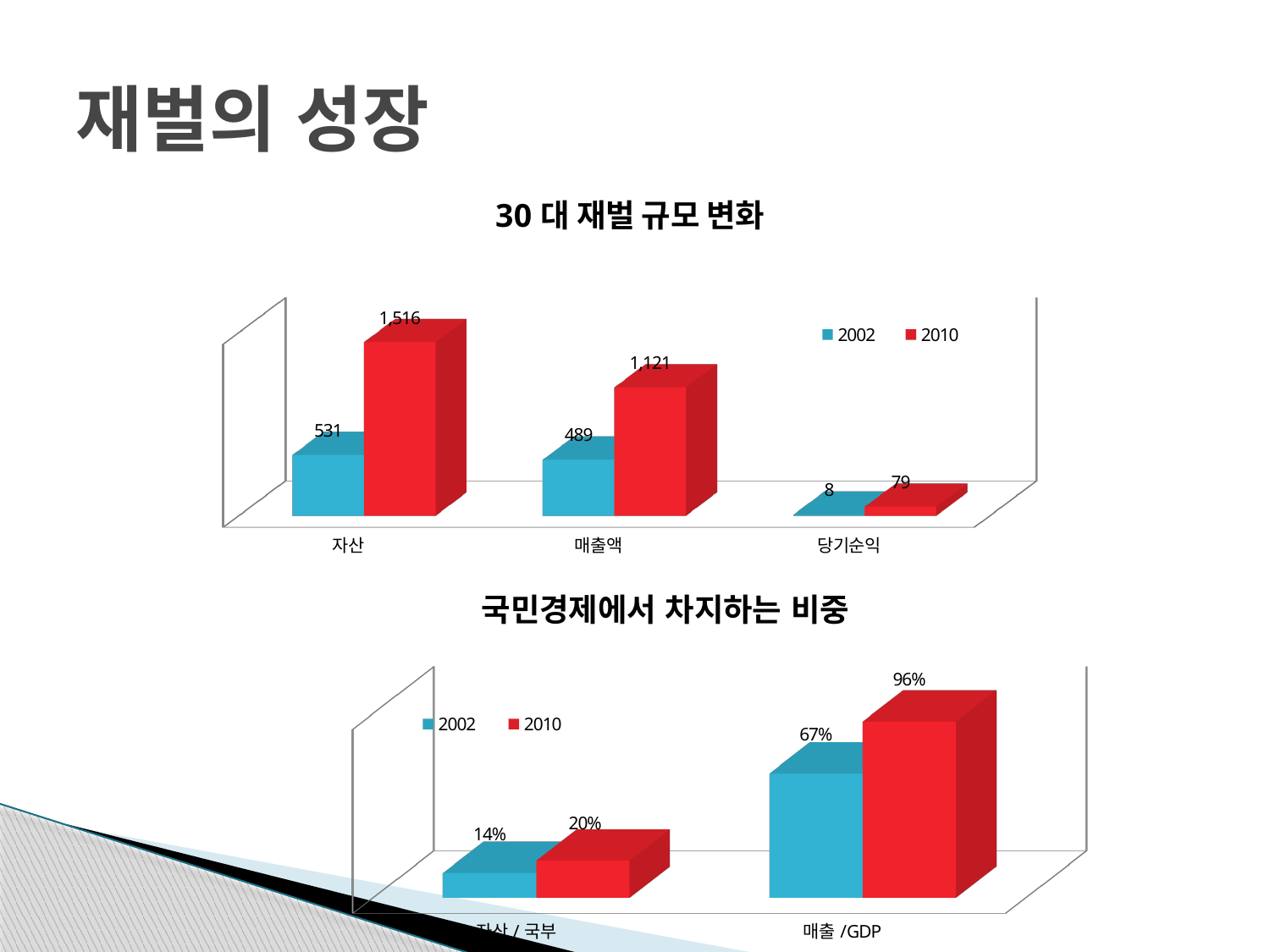
In the chart titled '30 대 재벌 규모 변화', what is the 2010 value for 당기순익? 79 In the chart titled '국민경제에서 차지하는 비중', what is the difference between the 2010 and 2002 values for 매출 /GDP? 29% What kind of chart is the chart titled '국민경제에서 차지하는 비중'? Bar chart In the chart titled '30 대 재벌 규모 변화', what is the 2002 value for 매출액? 489 In the chart titled '국민경제에서 차지하는 비중', what is the 2002 value for 매출 /GDP? 67% In the chart titled '30 대 재벌 규모 변화', what is the 2010 value for 자산? 1,516 In the chart titled '국민경제에서 차지하는 비중', which is larger for 매출 /GDP: the 2002 value or the 2010 value? 2010 In the chart titled '30 대 재벌 규모 변화', how many series does the legend list? 2 In the chart titled '30 대 재벌 규모 변화', which category has the lowest 2002 value? 당기순익 In the chart titled '30 대 재벌 규모 변화', what is the difference between the 2010 and 2002 values for 자산? 985 In the chart titled '30 대 재벌 규모 변화', how many categories are shown on the x axis? 3 In the chart titled '국민경제에서 차지하는 비중', what is the 2010 value for 매출 /GDP? 96%